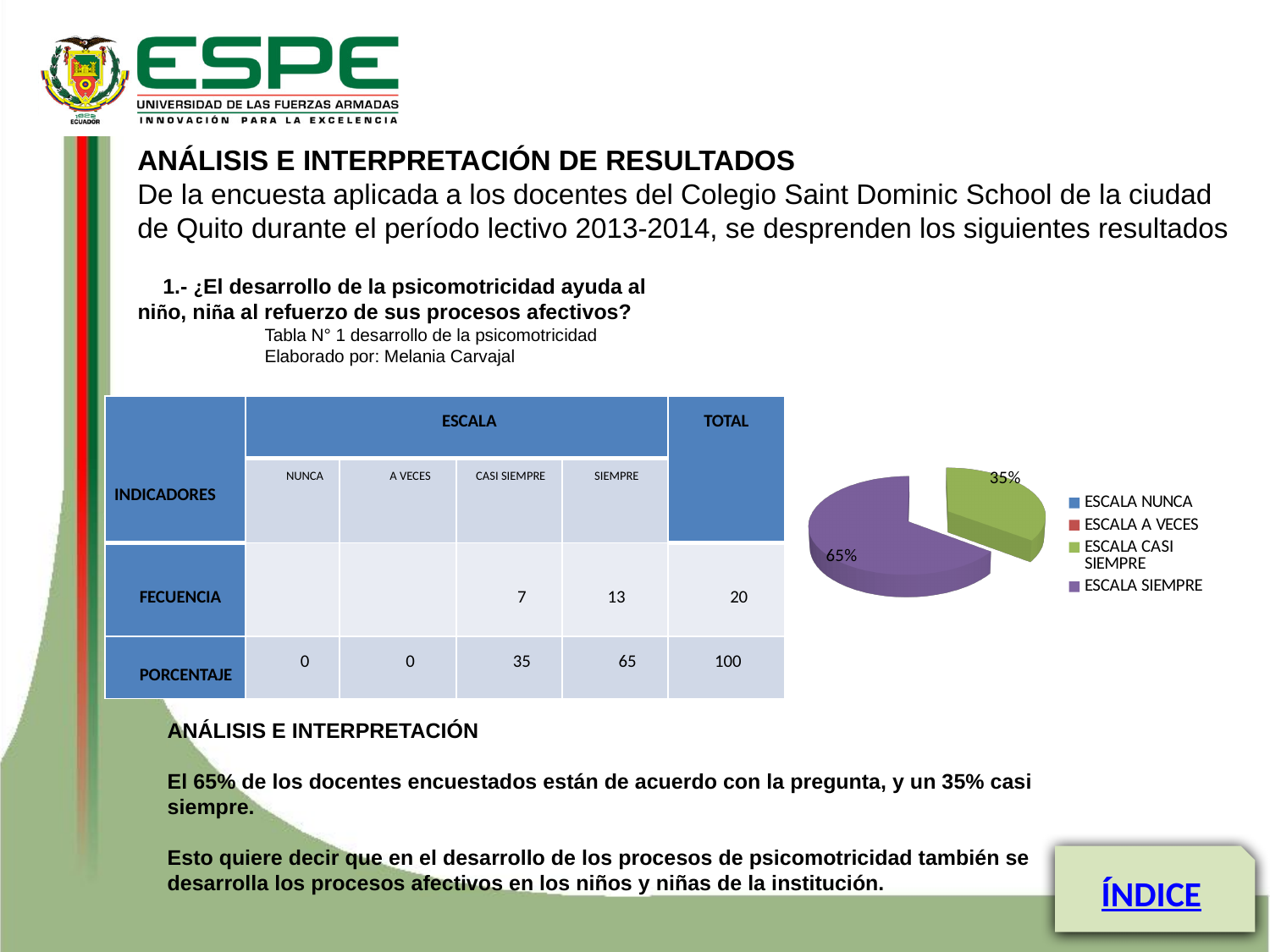
What share of the pie does ESCALA CASI SIEMPRE represent? 35% Which is larger in the pie chart, ESCALA SIEMPRE or ESCALA CASI SIEMPRE? ESCALA SIEMPRE How many slices with a visible share are shown in the pie chart? 2 What kind of chart is shown on the slide? pie chart What is the total of the two labelled slices in the pie chart? 100% Is the share for ESCALA SIEMPRE greater or less than 50%? greater What colour is the ESCALA CASI SIEMPRE slice in the pie chart? green How many entries does the pie chart's legend list? 4 What is the difference in percentage points between the ESCALA SIEMPRE slice and the ESCALA CASI SIEMPRE slice? 30 What share of the pie does ESCALA SIEMPRE represent? 65% What colour is the ESCALA SIEMPRE slice in the pie chart? purple Which legend entry has the largest slice of the pie? ESCALA SIEMPRE